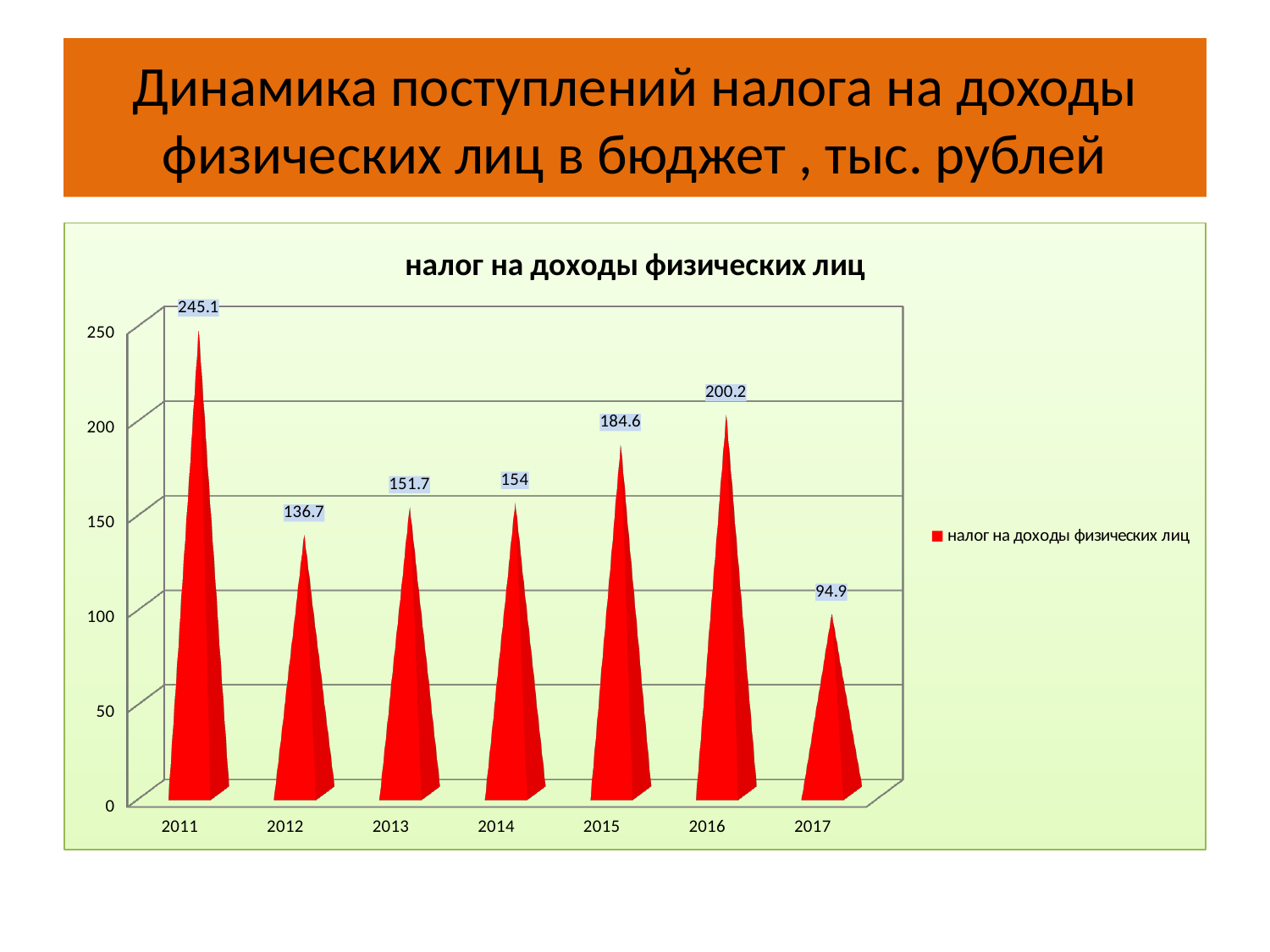
Is the value for 2016 greater or less than 150? greater Which year has the highest value? 2011 Which is larger, the value for 2012 or the value for 2013? 2013 Which year has the lowest value? 2017 What is the difference between the values for 2016 and 2015? 15.6 What is the value for 2017? 94.9 What is the title of the chart? налог на доходы физических лиц What is the value for 2011? 245.1 How many years are shown on the x axis? 7 What kind of chart is shown? bar chart How many series does the legend list? 1 What is the value for 2014? 154